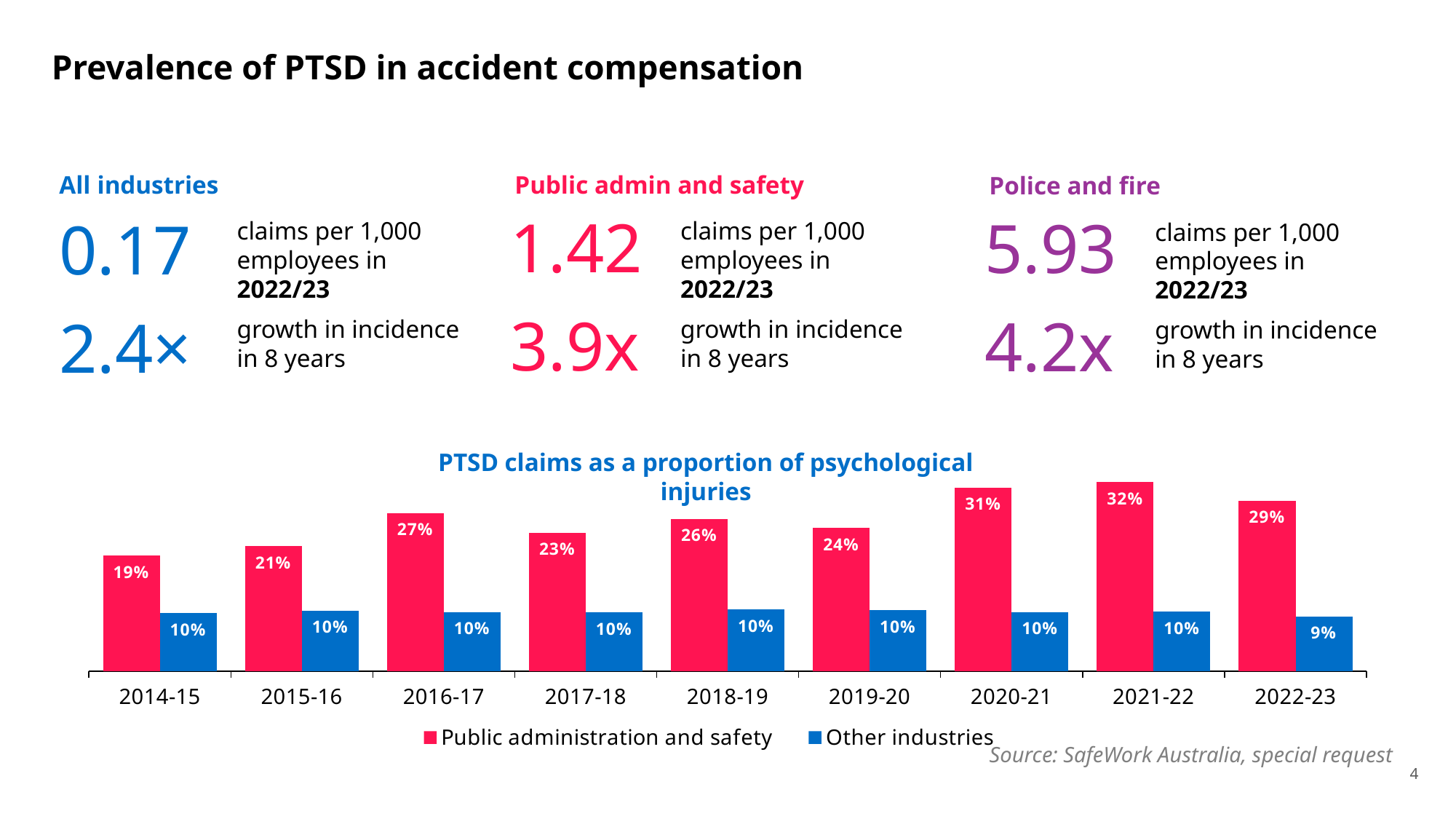
What is the value for Public administration and safety in 2014-15? 19% How many years are shown on the x axis? 9 In which year is the Public administration and safety value lowest? 2014-15 What is the value for Public administration and safety in 2020-21? 31% What is the title of the chart? PTSD claims as a proportion of psychological injuries What is the difference between the Public administration and safety values in 2022-23 and 2014-15? 10% How many series does the legend list? 2 Which is larger in 2017-18: Public administration and safety or Other industries? Public administration and safety What is the difference between the Public administration and safety value and the Other industries value in 2021-22? 22% What is the value for Other industries in 2022-23? 9% In which year is the Public administration and safety value highest? 2021-22 What kind of chart is shown? Bar chart